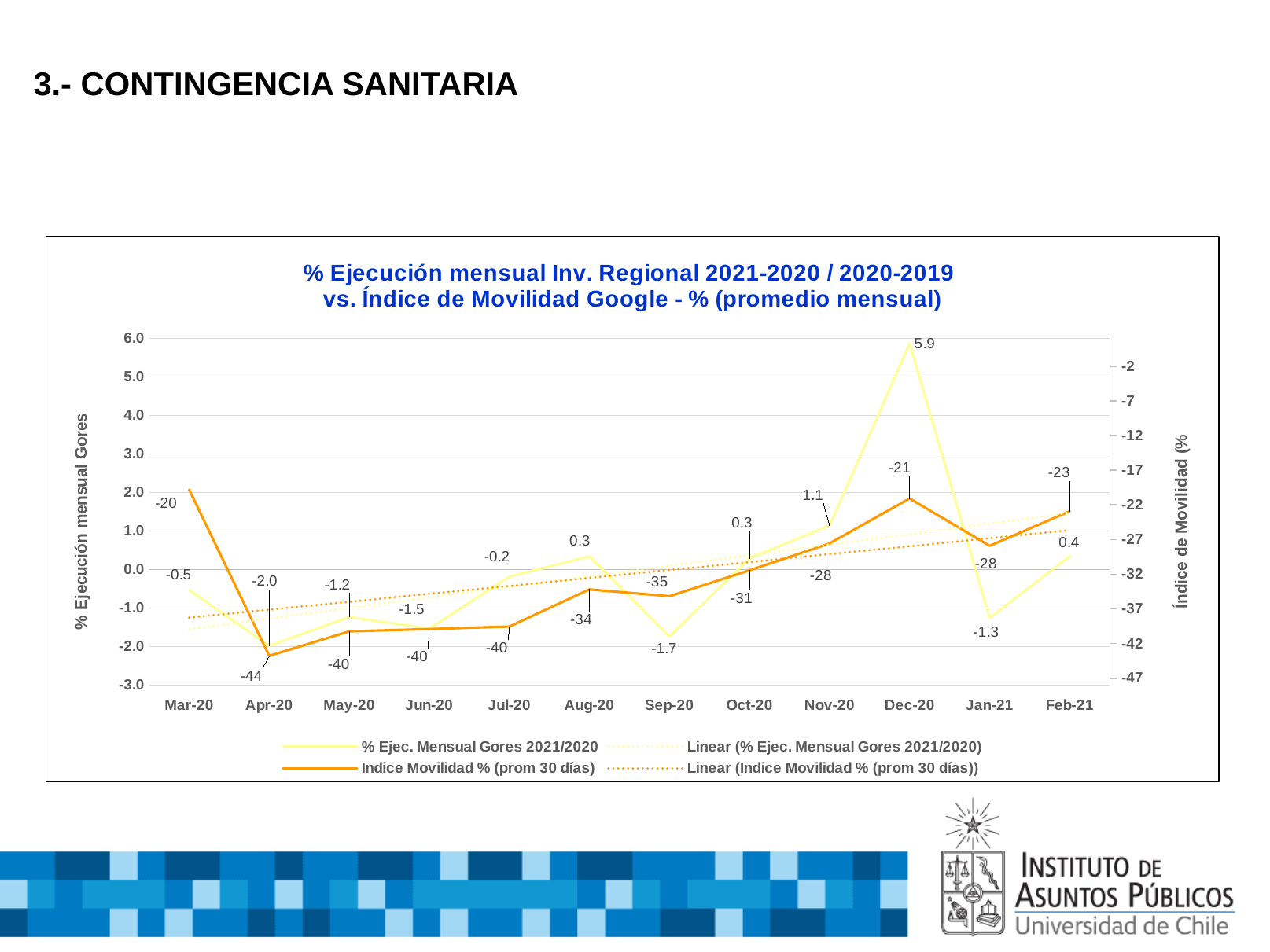
What is the value of % Ejec. Mensual Gores 2021/2020 for Dec-20? 5.9 Does the Indice Movilidad % (prom 30 días) line generally rise or fall from Apr-20 to Feb-21? Rise How many months are shown on the x axis? 12 Which month has a higher % Ejec. Mensual Gores 2021/2020 value, Nov-20 or Jan-21? Nov-20 What is the difference between the Indice Movilidad % values for Mar-20 and Apr-20? 24 In which month is Indice Movilidad % (prom 30 días) at its lowest? Apr-20 In which month does % Ejec. Mensual Gores 2021/2020 reach its highest value? Dec-20 What kind of chart is shown on the slide? Line chart What is the value of Indice Movilidad % (prom 30 días) for Feb-21? -23 What is the value of Indice Movilidad % (prom 30 días) for Apr-20? -44 What is the value of % Ejec. Mensual Gores 2021/2020 for Sep-20? -1.7 How many entries does the legend list? 4